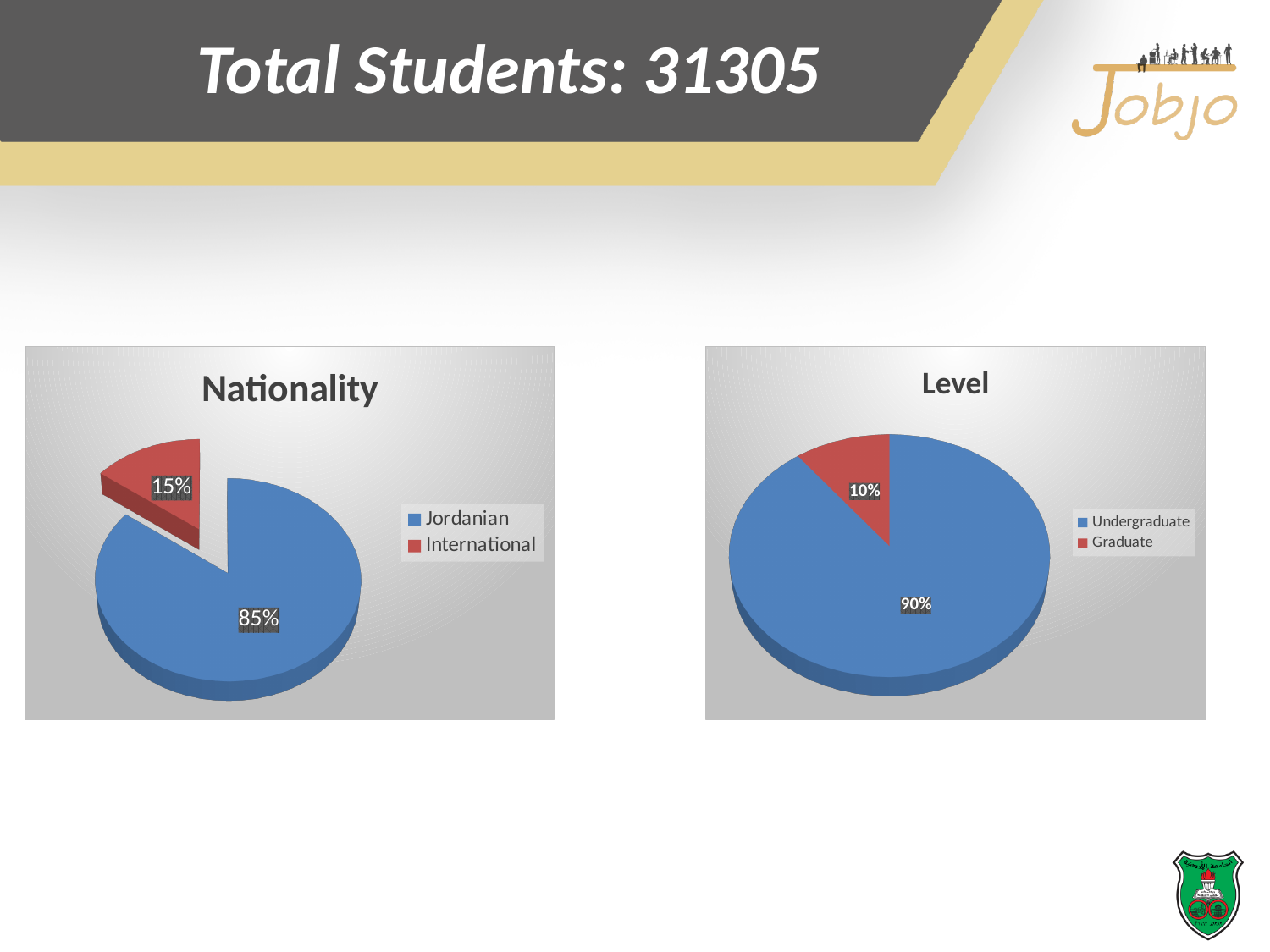
In the Level chart, which category has the smallest slice? Graduate In the Nationality chart, what is the difference in percentage points between the Jordanian and International slices? 70 What kind of chart is the Level chart? Pie chart In the Nationality chart, what share of students are International? 15% How many slices does the Nationality chart have? 2 In the Level chart, what is the difference in percentage points between the Undergraduate and Graduate slices? 80 In the Nationality chart, which colour represents the International slice? Red How many entries does the legend of the Level chart list? 2 In the Level chart, what share of students are Undergraduate? 90% In the Nationality chart, what share of students are Jordanian? 85% In the Nationality chart, which category has the largest slice? Jordanian